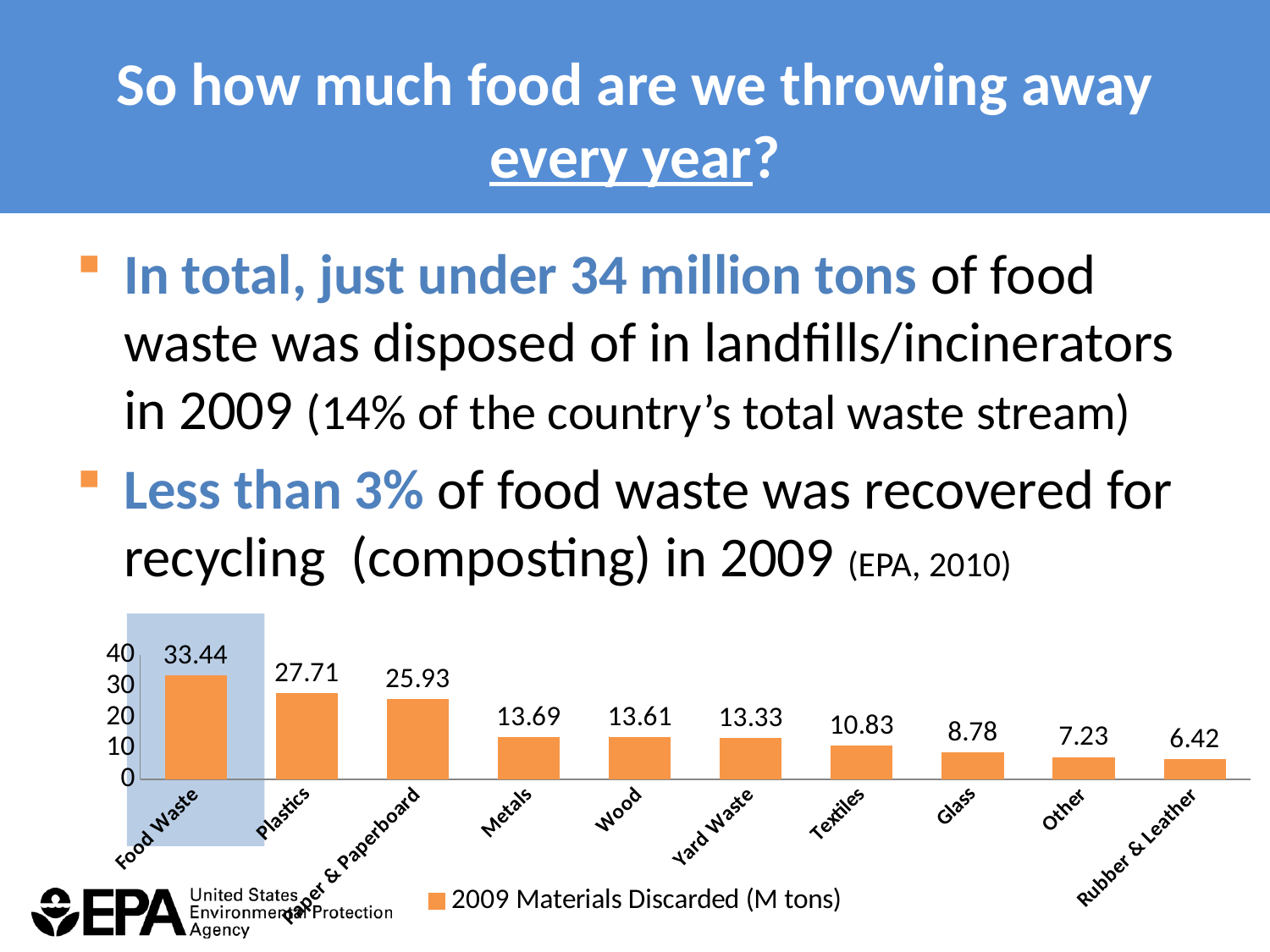
Is the value for Paper & Paperboard greater or less than 20? greater How many categories are shown in the chart? 10 What is the legend entry for the series in the chart? 2009 Materials Discarded (M tons) Which category has the lowest value in the chart? Rubber & Leather Which is larger, the value for Textiles or the value for Glass? Textiles What is the difference between the values for Food Waste and Plastics? 5.73 What is the value for Plastics in the chart? 27.71 What is the value for Glass in the chart? 8.78 How many series does the chart legend list? 1 What is the value for Food Waste in the chart? 33.44 Which category has the highest value in the chart? Food Waste What kind of chart is shown on the slide? bar chart